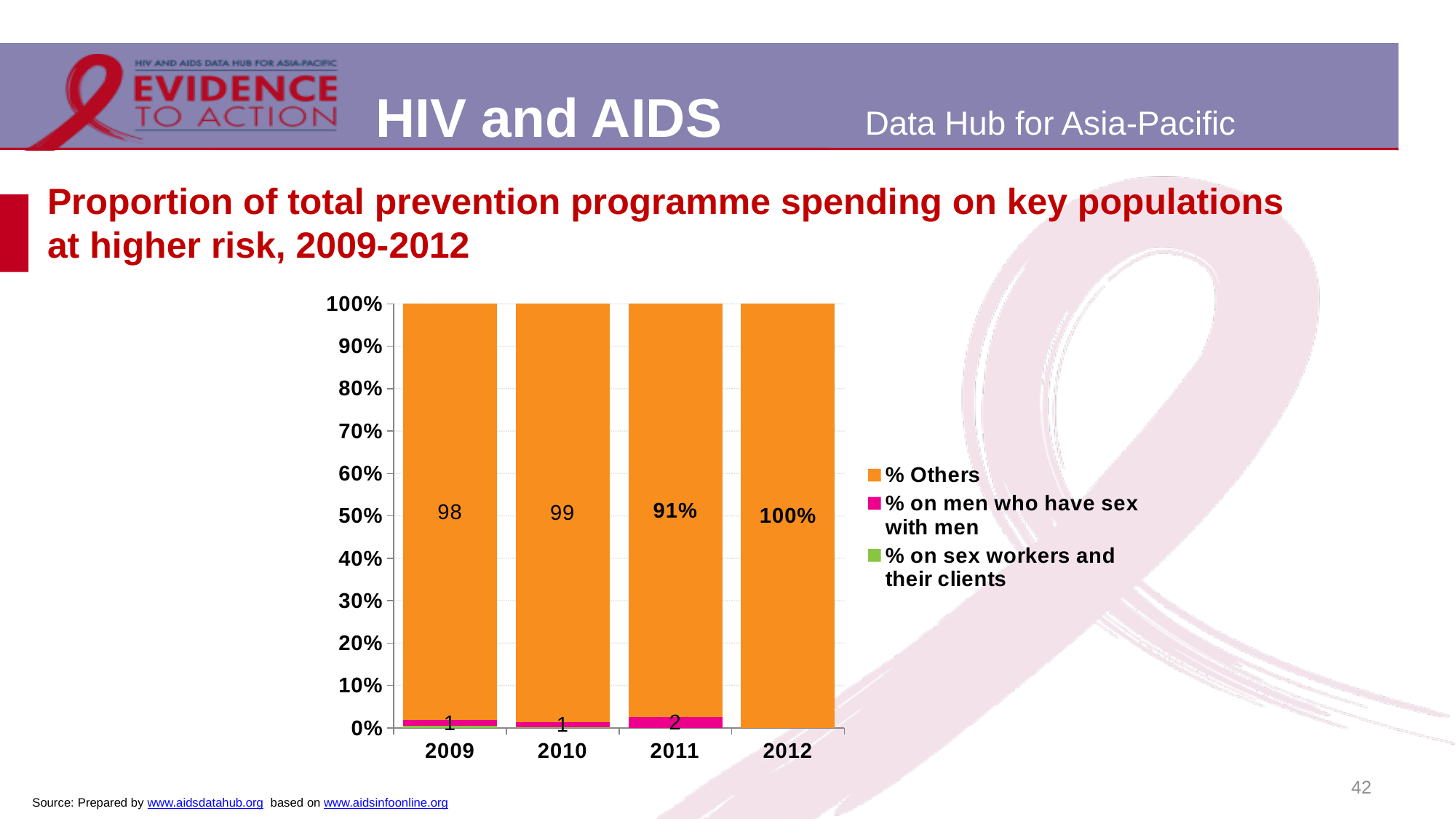
What is the value labelled for % Others in 2011? 91% What kind of chart is shown on the slide? bar chart How many series does the chart's legend list? 3 In which year is the % Others value the highest? 2012 Which year has the larger value for % on men who have sex with men, 2010 or 2011? 2011 How many years are shown on the x axis of the chart? 4 Which series is shown in orange in the chart? % Others What is the value labelled for % on men who have sex with men in 2009? 1 What is the value labelled for % Others in 2010? 99 What is the value labelled for % on men who have sex with men in 2011? 2 What is the value labelled for % Others in 2009? 98 What is the value labelled for % Others in 2012? 100%